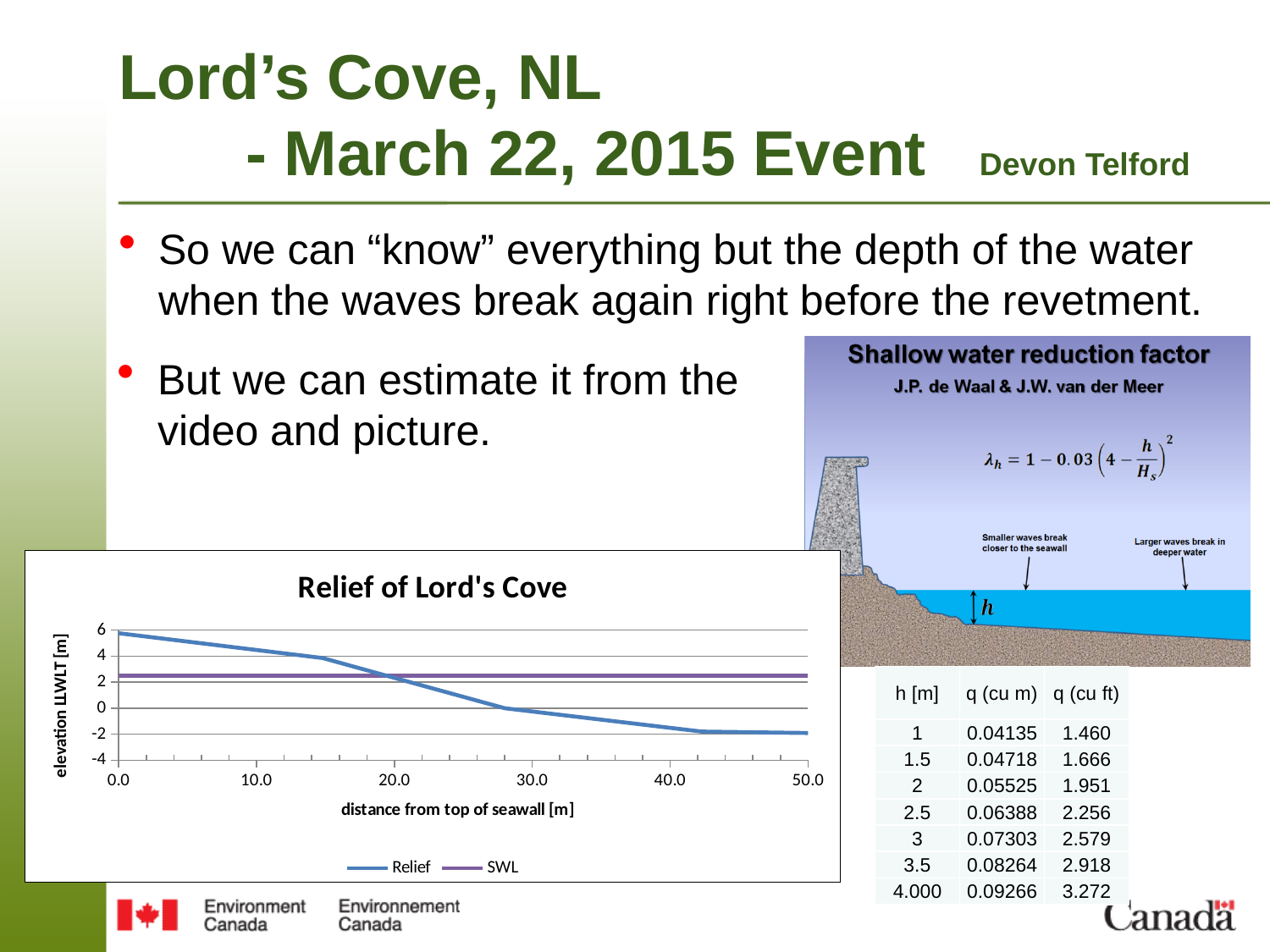
What is the title of the chart on the slide? Relief of Lord's Cove In the 'Relief of Lord's Cove' chart, is the Relief value at distance 30.0 greater or less than 2? less How many series does the legend of the 'Relief of Lord's Cove' chart list? 2 In the 'Relief of Lord's Cove' chart, at distance 40.0, which series has the higher value: Relief or SWL? SWL What is the x-axis title of the 'Relief of Lord's Cove' chart? distance from top of seawall [m] In the 'Relief of Lord's Cove' chart, does the Relief series rise or fall as distance from the top of the seawall increases? fall In the 'Relief of Lord's Cove' chart, is the Relief value at distance 50.0 greater or less than 0? less In the 'Relief of Lord's Cove' chart, which is larger: the Relief value at distance 0.0 or at distance 40.0? 0.0 What kind of chart is 'Relief of Lord's Cove'? line chart In the 'Relief of Lord's Cove' chart, is the SWL value greater or less than 0? greater